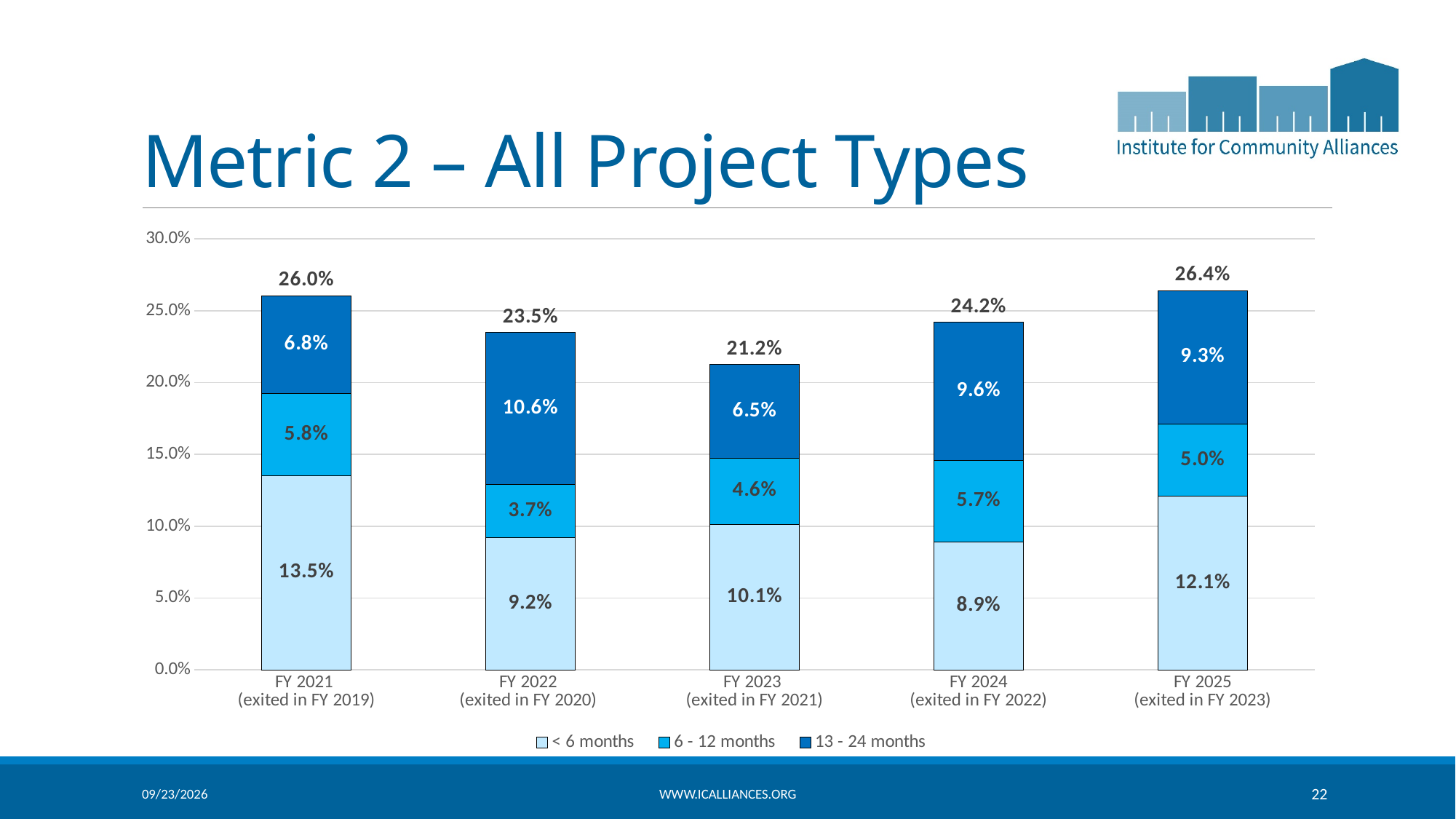
What is the title of the slide? Metric 2 – All Project Types How many fiscal years are shown on the x axis? 5 Which fiscal year has the highest stacked bar total? FY 2025 What is the value for '6 - 12 months' in FY 2024? 5.7% Which is larger: the '13 - 24 months' value for FY 2024 or for FY 2025? FY 2024 What kind of chart is shown on the slide? Stacked bar chart What is the difference between the '< 6 months' values for FY 2021 and FY 2024? 4.6% What is the value for '< 6 months' in FY 2021? 13.5% What is the value for '13 - 24 months' in FY 2022? 10.6% How many series does the legend list? 3 What is the total of the stacked bar for FY 2025? 26.4% Which fiscal year has the lowest stacked bar total? FY 2023